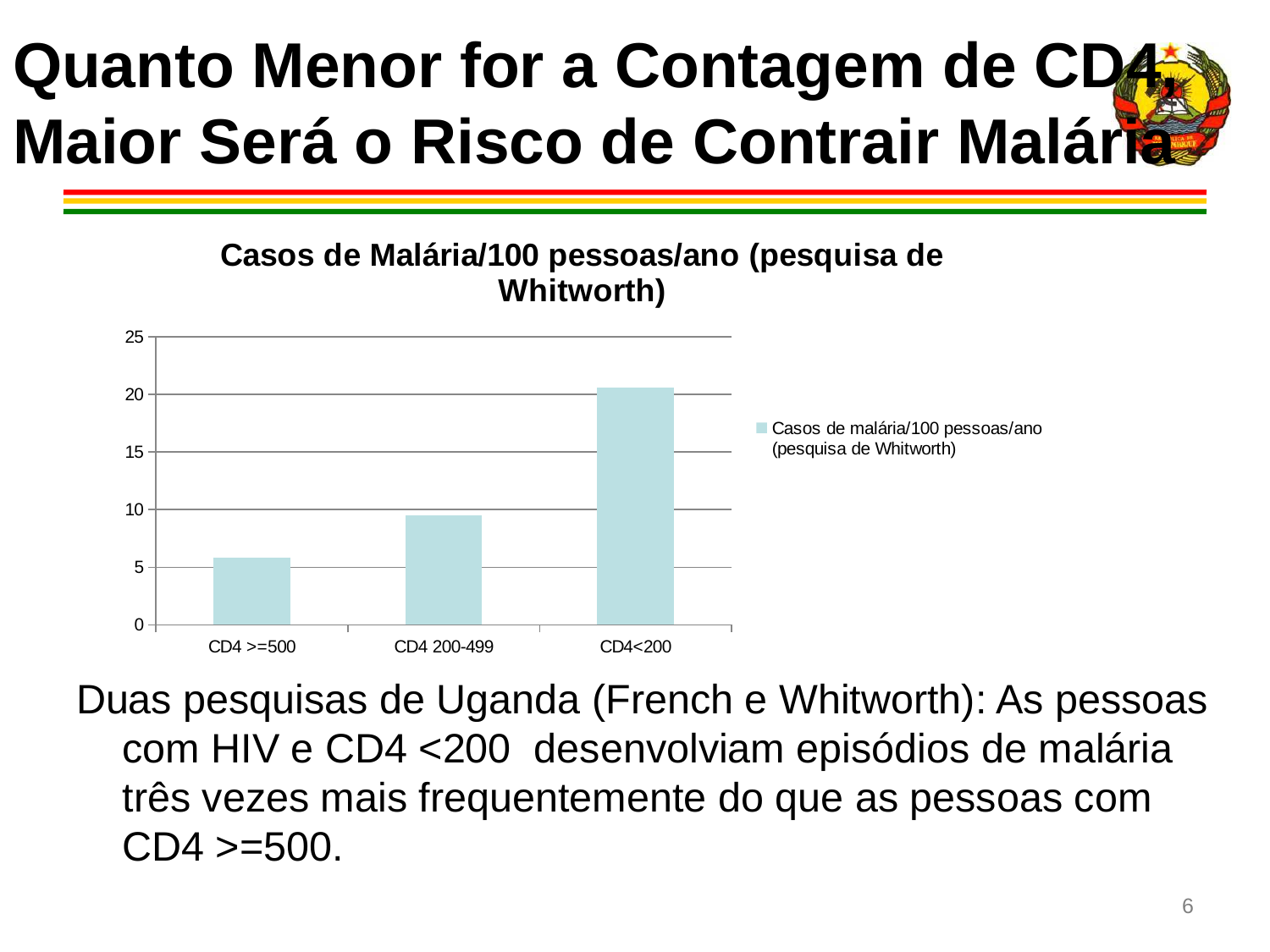
Do the values rise or fall moving from left to right along the x axis? rise Which category has the highest value in the chart? CD4<200 What is the title of the chart? Casos de Malária/100 pessoas/ano (pesquisa de Whitworth) What is the highest value shown on the chart's vertical axis? 25 What kind of chart is shown on the slide? bar chart Is the value for CD4<200 greater or less than 20? greater Is the value for CD4 >=500 greater or less than 10? less How many categories are shown on the x axis of the chart? 3 Is the value for CD4 200-499 greater or less than 5? greater How many series does the chart's legend list? 1 Which category has the lowest value in the chart? CD4 >=500 Which is larger, the value for CD4 200-499 or the value for CD4 >=500? CD4 200-499